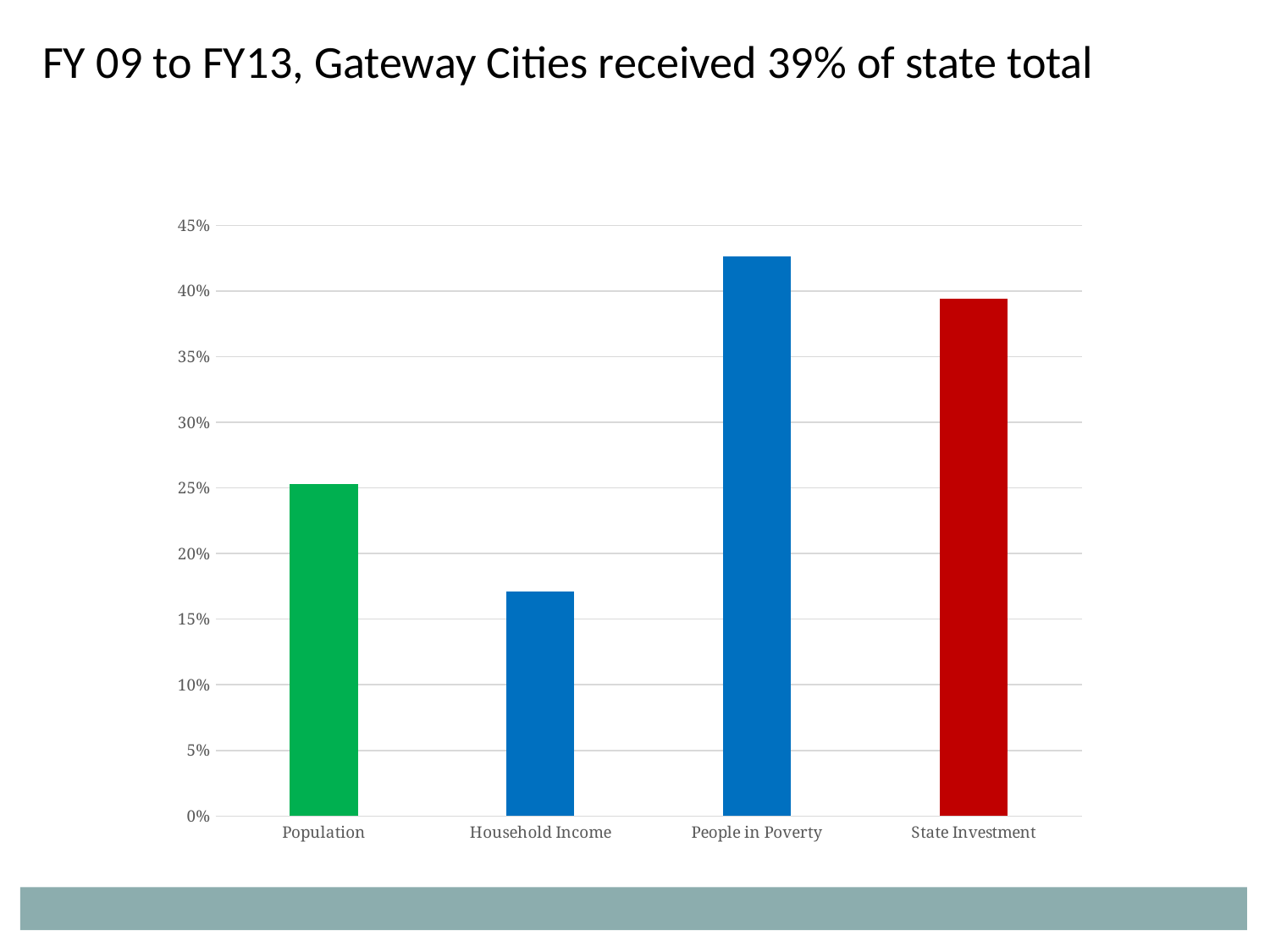
Which category has the lowest bar? Household Income What is the title of the slide? FY 09 to FY13, Gateway Cities received 39% of state total Is the value for People in Poverty greater or less than 40%? greater Which category has the highest bar? People in Poverty Is the value for Household Income greater or less than 20%? less Which is larger, the value for People in Poverty or the value for State Investment? People in Poverty Is the value for State Investment greater or less than 35%? greater Which is larger, the value for Population or the value for Household Income? Population How many categories are plotted on the chart? 4 What colour is the State Investment bar? red What kind of chart is shown on the slide? bar chart